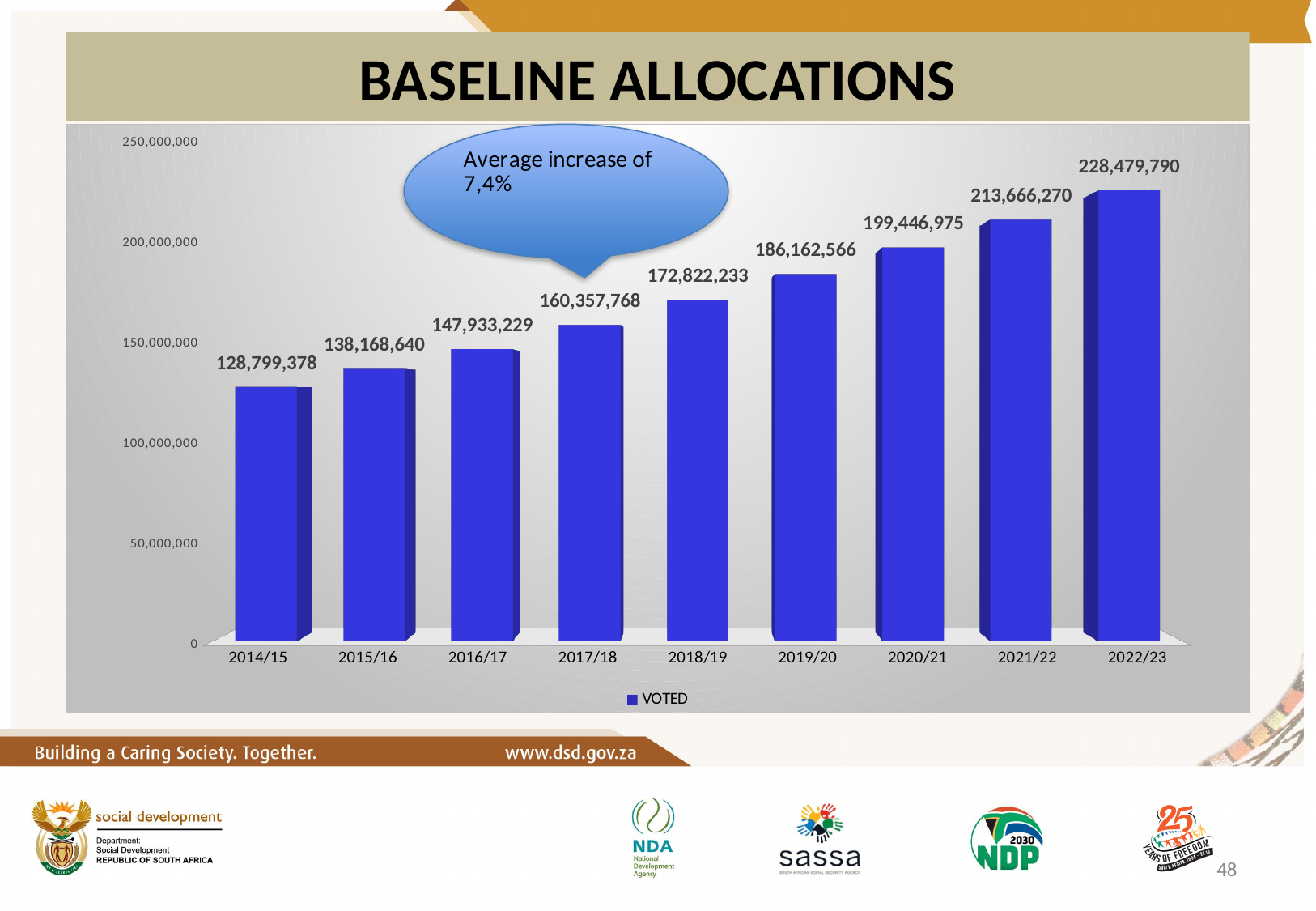
Is the value for 2020/21 greater or less than 200,000,000? less What average increase does the callout on the chart state? 7,4% What is the value for 2018/19? 172,822,233 How many years are shown on the x axis? 9 What is the value for 2022/23? 228,479,790 Which year has the lowest value? 2014/15 What kind of chart is shown? bar chart What is the value for 2014/15? 128,799,378 What is the difference between the values for 2022/23 and 2014/15? 99,680,412 What is the difference between the values for 2015/16 and 2014/15? 9,369,262 Which year has the highest value? 2022/23 Which is larger, the value for 2019/20 or the value for 2017/18? 2019/20